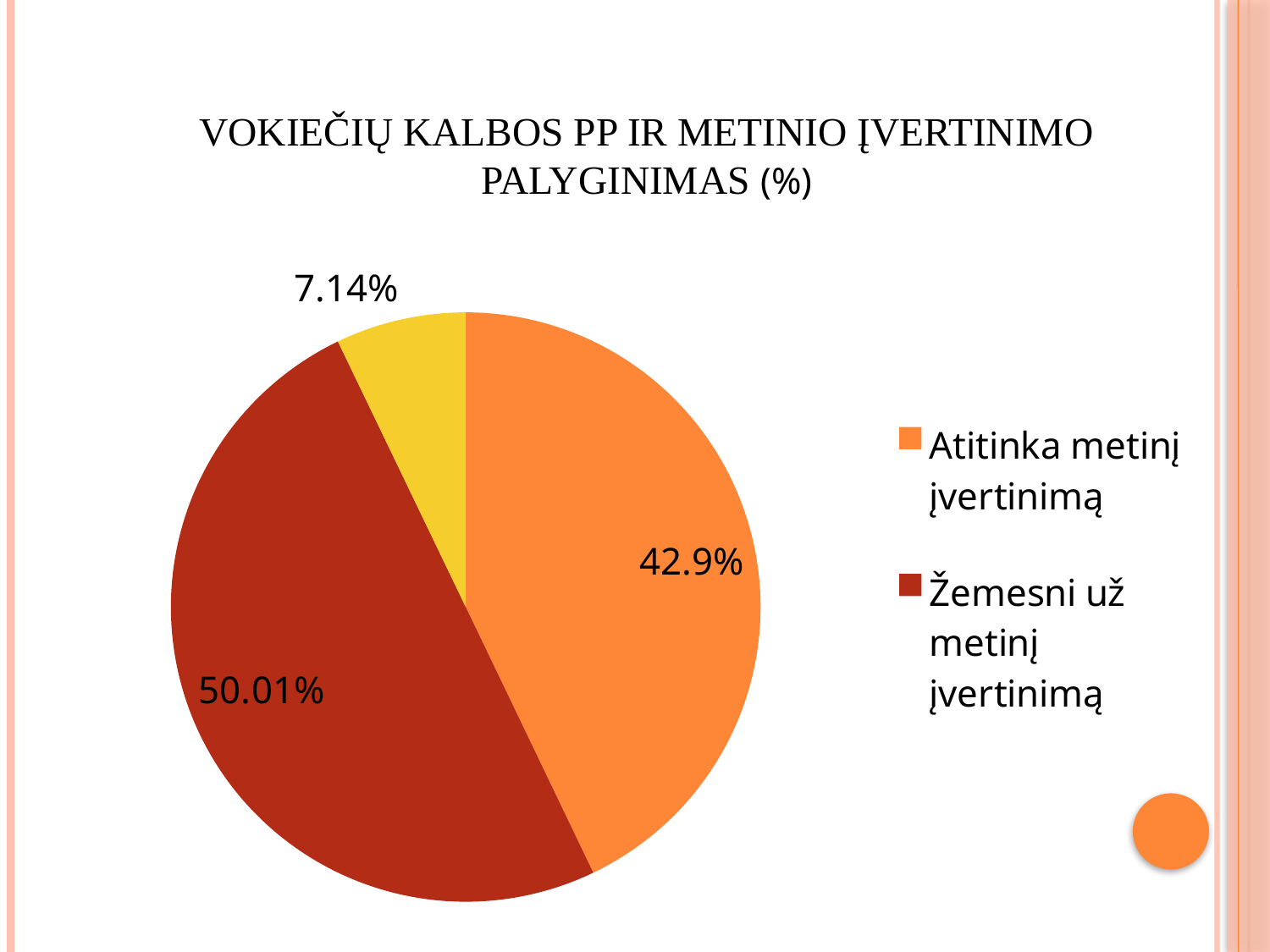
Which slice of the pie is the largest? Žemesni už metinį įvertinimą What kind of chart is shown on the slide? pie chart How many slices does the pie chart have? 3 Which is larger: the slice for "Atitinka metinį įvertinimą" or the slice for "Žemesni už metinį įvertinimą"? Žemesni už metinį įvertinimą What percentage of the pie is labelled for "Atitinka metinį įvertinimą"? 42.9% How many entries does the legend list? 2 What colour is the slice for "Žemesni už metinį įvertinimą"? dark red What percentage of the pie is labelled for "Žemesni už metinį įvertinimą"? 50.01% Is the share for "Atitinka metinį įvertinimą" greater or less than 50%? less What is the value of the smallest slice of the pie? 7.14% What is the difference between the "Žemesni už metinį įvertinimą" slice and the "Atitinka metinį įvertinimą" slice? 7.11% What is the title of the chart? Vokiečių kalbos PP ir metinio įvertinimo palyginimas (%)